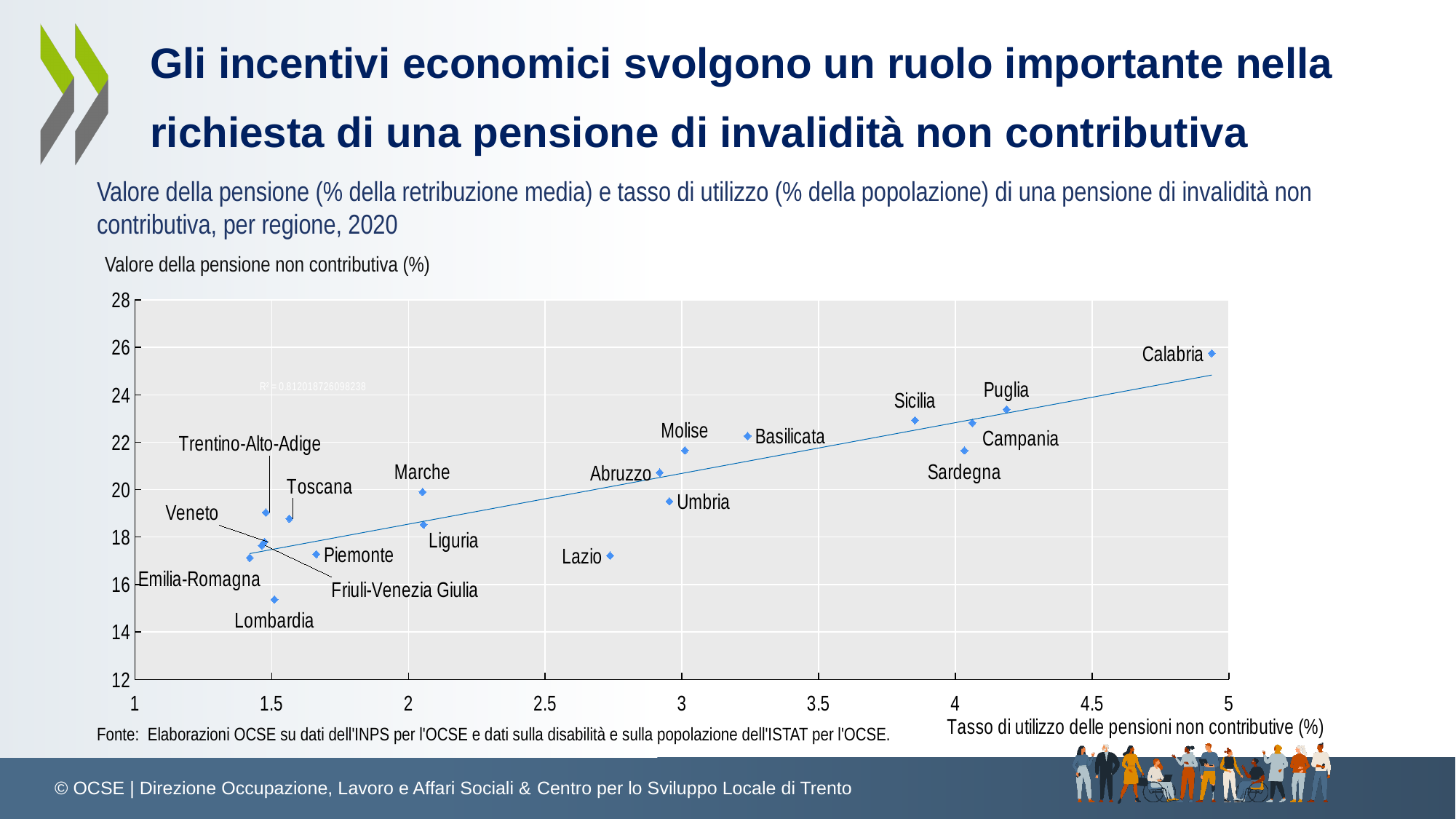
Which region has the highest take-up rate of non-contributory pensions (x axis)? Calabria Is the pension value for Umbria greater or less than 20? less Is the take-up rate for Lazio greater or less than 2.5? greater As the take-up rate increases along the x axis, does the pension value generally rise or fall? Rise Is the pension value for Calabria greater or less than 24? greater Which region has a higher pension value, Puglia or Sardegna? Puglia How many regions are plotted on the chart? 19 Which region has a higher pension value, Marche or Liguria? Marche Which region has the lowest value of the non-contributory pension (% of average wage)? Lombardia What kind of chart is shown on the slide? Scatter chart Which region has the highest value of the non-contributory pension (% of average wage)? Calabria